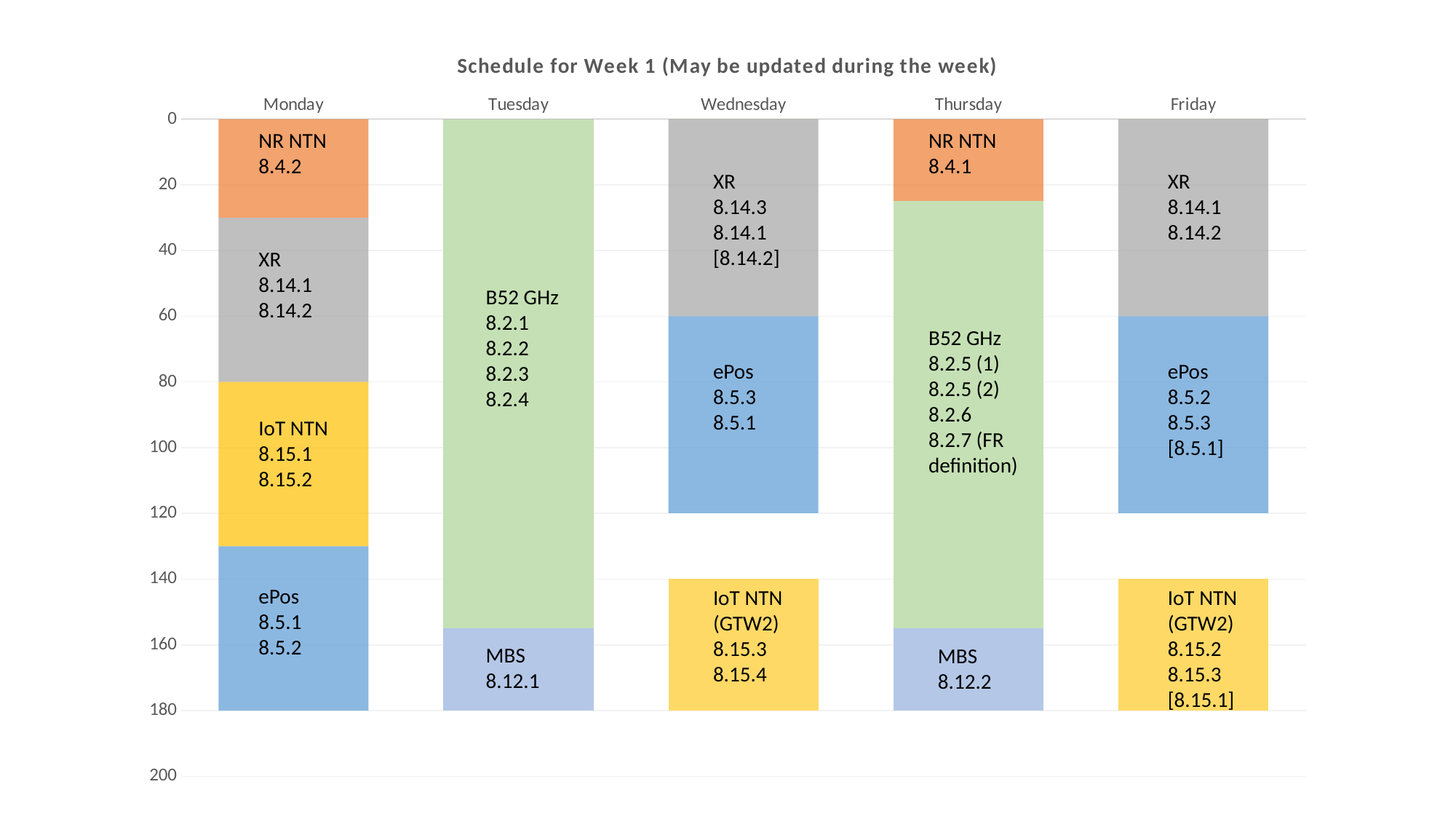
Which agenda item is listed in the MBS block on Thursday? 8.12.2 How many days (categories) are shown along the top of the chart? 5 Which topic occupies the top block of the Tuesday bar? B52 GHz Is the NR NTN block on Thursday taller or shorter than the NR NTN block on Monday? shorter Is the boundary between the B52 GHz block and the MBS block on Tuesday greater or less than 140 on the axis? greater Which day has the most blocks stacked in its bar? Monday At what axis value does the ePos block on Friday end? 120 What kind of chart is shown on the slide? stacked bar chart How many blocks are stacked in the Monday bar? 4 At what axis value does the XR block on Wednesday end? 60 What is the title of the chart? Schedule for Week 1 (May be updated during the week) On which two days does an NR NTN block appear? Monday and Thursday